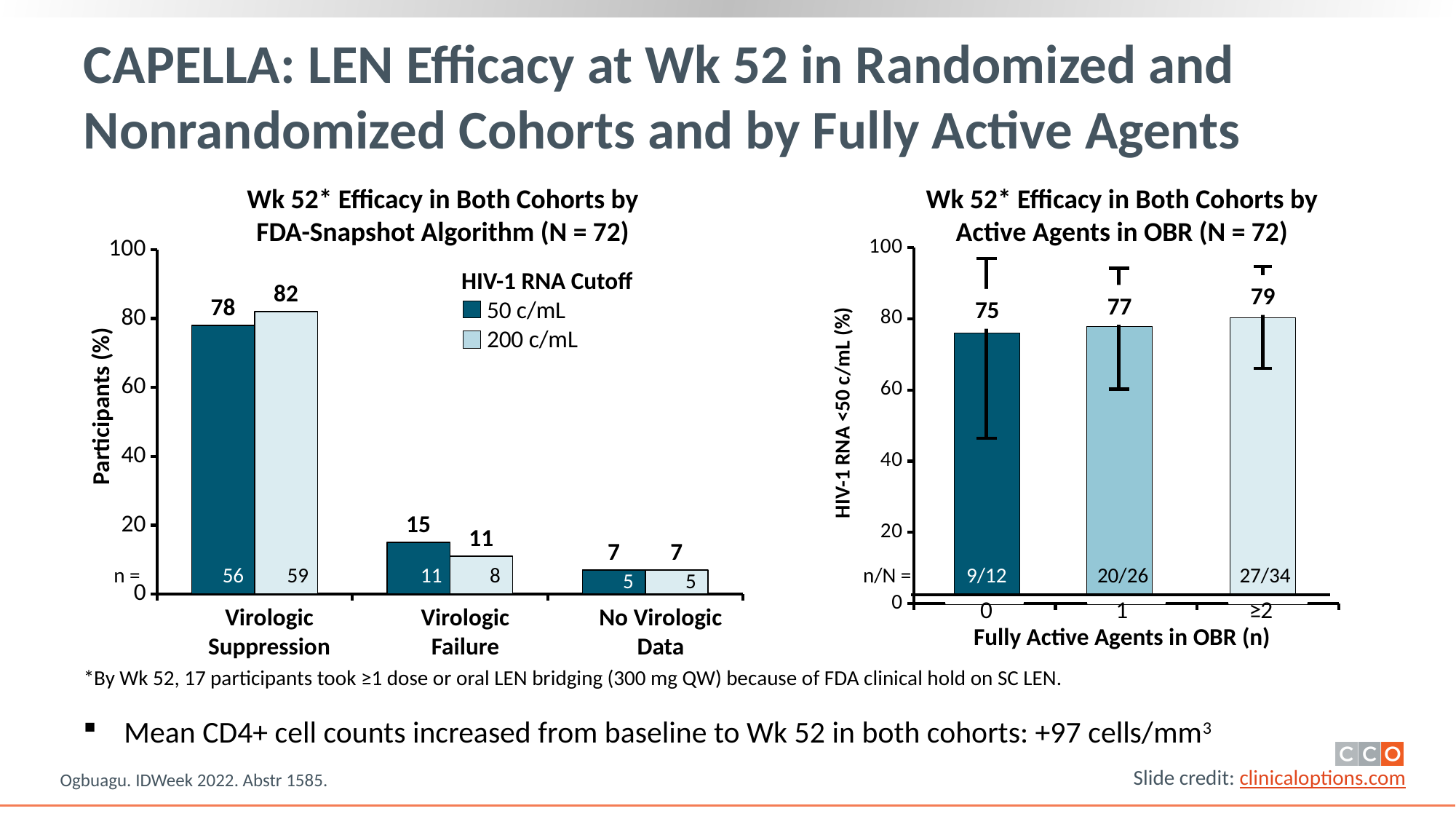
In the left chart (FDA-Snapshot Algorithm), how many categories are shown on the x axis? 3 In the left chart (FDA-Snapshot Algorithm), what is the difference between the 200 c/mL and 50 c/mL virologic suppression percentages? 4 In the left chart (FDA-Snapshot Algorithm), how many series does the legend list? 2 In the right chart (Active Agents in OBR), what percentage of participants with 1 fully active agent had HIV-1 RNA <50 c/mL? 77 In the left chart (FDA-Snapshot Algorithm), what is the n value shown for virologic suppression at the 200 c/mL cutoff? 59 What kind of chart is the right chart (Active Agents in OBR)? bar chart In the right chart (Active Agents in OBR), do the values rise or fall as the number of fully active agents increases? rise In the left chart (FDA-Snapshot Algorithm), which category has the lowest values? No Virologic Data In the left chart (FDA-Snapshot Algorithm), what percentage of participants achieved virologic suppression at the 50 c/mL cutoff? 78 In the right chart (Active Agents in OBR), what is the n/N value shown for ≥2 fully active agents? 27/34 In the right chart (Active Agents in OBR), which group has the highest percentage with HIV-1 RNA <50 c/mL? ≥2 In the left chart (FDA-Snapshot Algorithm), what percentage of participants had virologic failure at the 200 c/mL cutoff? 11